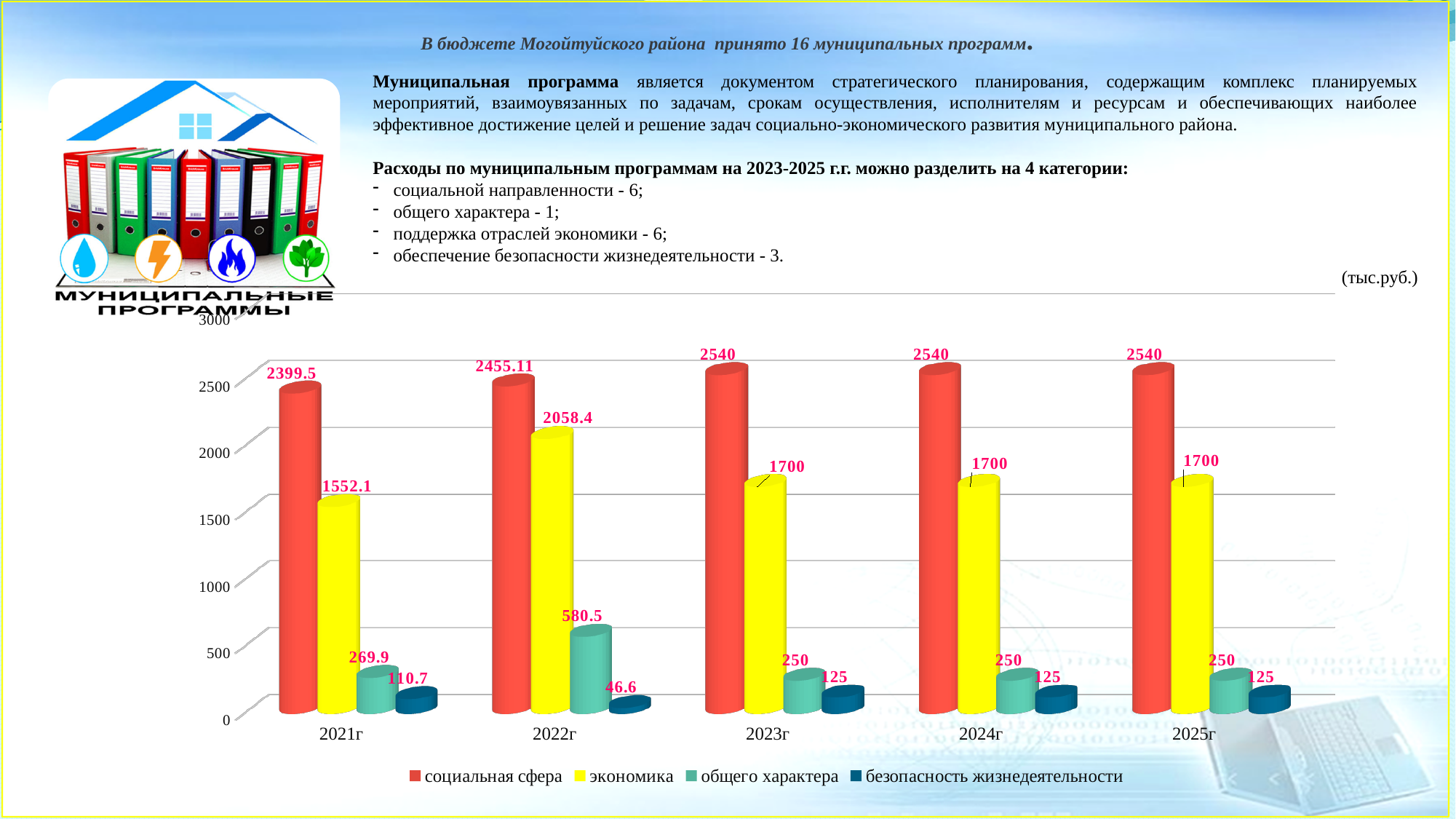
In which year is the value for общего характера the highest? 2022г What unit is indicated above the chart? тыс.руб. Which is larger: the value for экономика in 2021г or in 2023г? 2023г In which year is the value for безопасность жизнедеятельности the lowest? 2022г How many years are shown on the x axis? 5 What is the value for экономика in 2022г? 2058.4 By how much does the value for социальная сфера in 2022г exceed the value in 2021г? 55.61 How many series does the legend list? 4 What kind of chart is shown on the slide? bar chart What is the value for социальная сфера in 2021г? 2399.5 Does the value for социальная сфера rise or fall from 2021г to 2023г? rise What is the value for безопасность жизнедеятельности in 2022г? 46.6